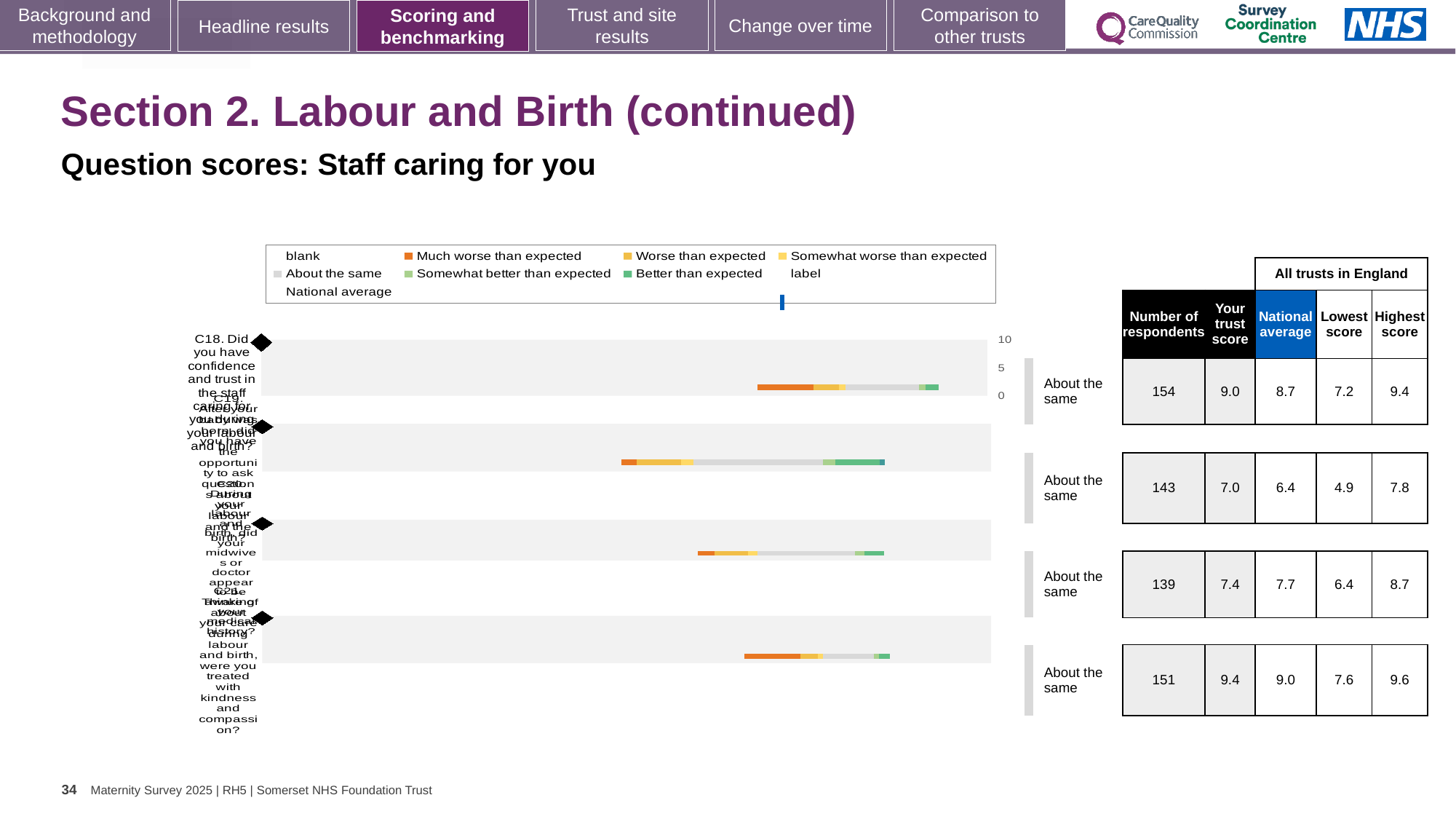
What benchmark category is shown next to each of the four question bars? About the same What kind of chart is shown on the slide? bar chart What is the lowest score among all trusts in England for the second question row in the table? 4.9 How many question bars are plotted in the chart? 4 For the third question row, which is larger: the trust's score or the national average? the national average (7.7) What is the national average for question C18 (confidence and trust in the staff caring for you)? 8.7 Which question row has the highest 'Your trust score' in the table? C21 (the fourth row), 9.4 Which question row has the lowest number of respondents in the table? the third row (C20), 139 By how much does the trust's score for C18 exceed the national average for C18? 0.3 What is the trust's score for question C18 (confidence and trust in the staff caring for you)? 9.0 What is the number of respondents for question C18 (confidence and trust in the staff caring for you)? 154 What is the highest score among all trusts in England for the last question in the table (C21, treated with kindness and compassion)? 9.6